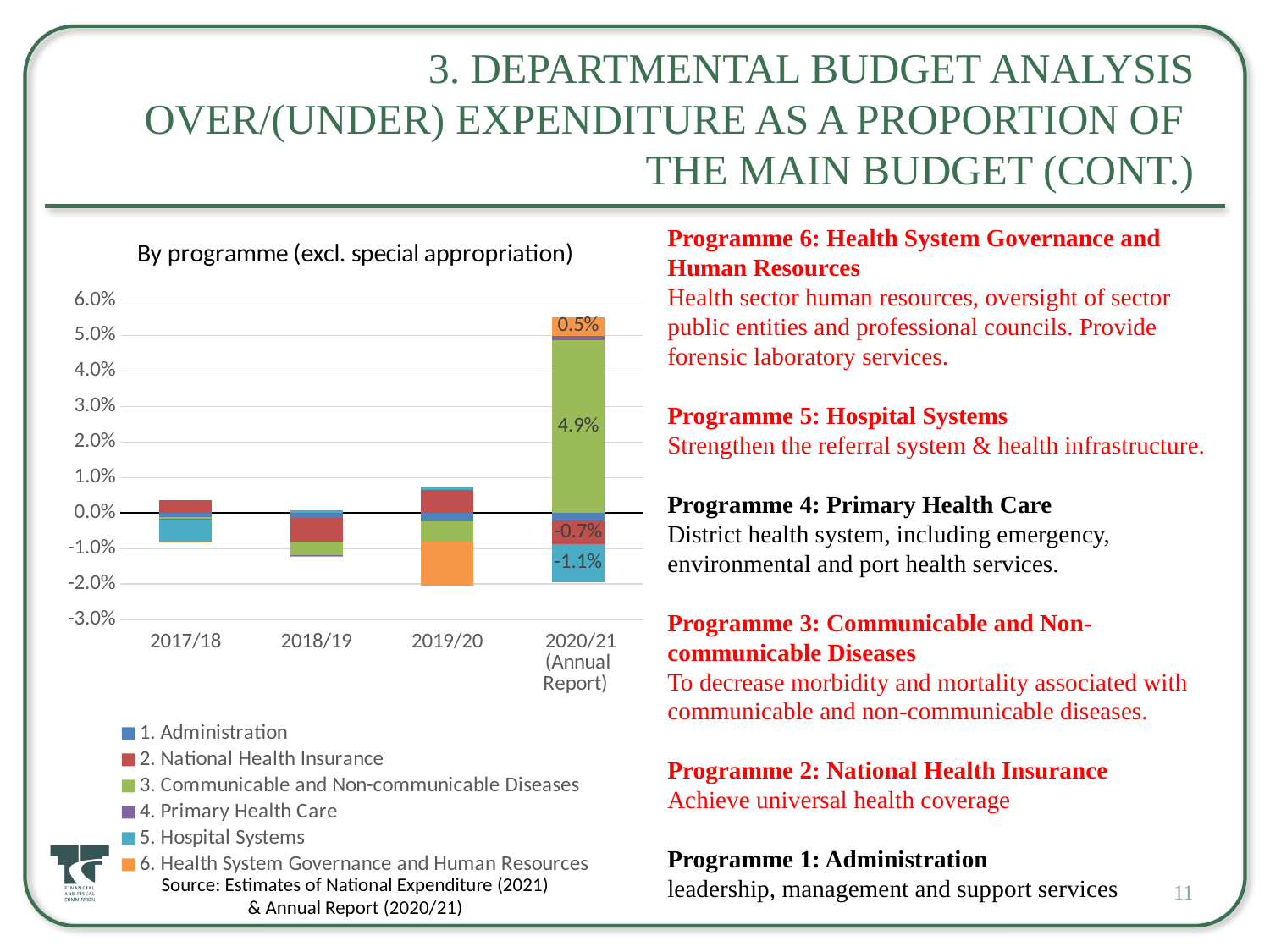
How many series does the legend list? 6 Is the value for 3. Communicable and Non-communicable Diseases in 2020/21 (Annual Report) greater or less than 4.0%? greater How many financial years are shown on the x axis? 4 What is the value for 6. Health System Governance and Human Resources in 2020/21 (Annual Report)? 0.5% What is the difference between the 2020/21 (Annual Report) values for 3. Communicable and Non-communicable Diseases and 6. Health System Governance and Human Resources? 4.4 percentage points What is the value for 2. National Health Insurance in 2020/21 (Annual Report)? -0.7% What is the value for 5. Hospital Systems in 2020/21 (Annual Report)? -1.1% What is the value for 3. Communicable and Non-communicable Diseases in 2020/21 (Annual Report)? 4.9% What kind of chart is shown on the slide? Stacked bar chart What is the title of the chart? By programme (excl. special appropriation) In 2020/21 (Annual Report), which is larger: the value for 3. Communicable and Non-communicable Diseases or the value for 6. Health System Governance and Human Resources? 3. Communicable and Non-communicable Diseases Which year has the largest positive stacked bar? 2020/21 (Annual Report)